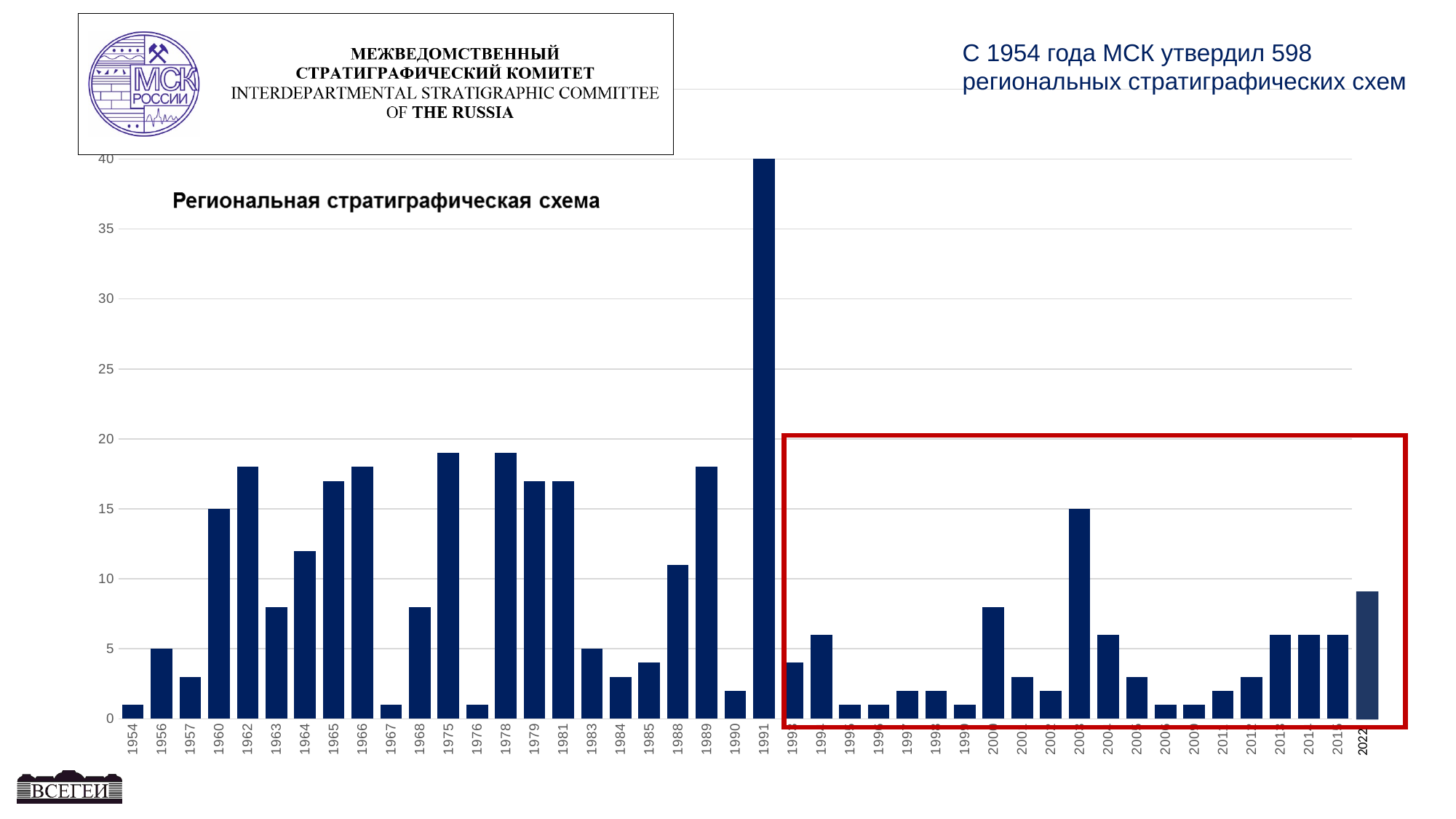
Is the value for 1990 greater or less than 5? less Which year has the highest bar in the chart? 1991 What is the value for 1991? 40 Is the value for 1988 greater or less than 10? greater What is the value for 1956? 5 Is the value for 1962 greater or less than 15? greater What is the title of the chart? Региональная стратиграфическая схема Which is larger, the value for 1962 or the value for 1963? 1962 What is the value for 1960? 15 What kind of chart is shown on the slide? bar chart Which is larger, the value for 1975 or the value for 1964? 1975